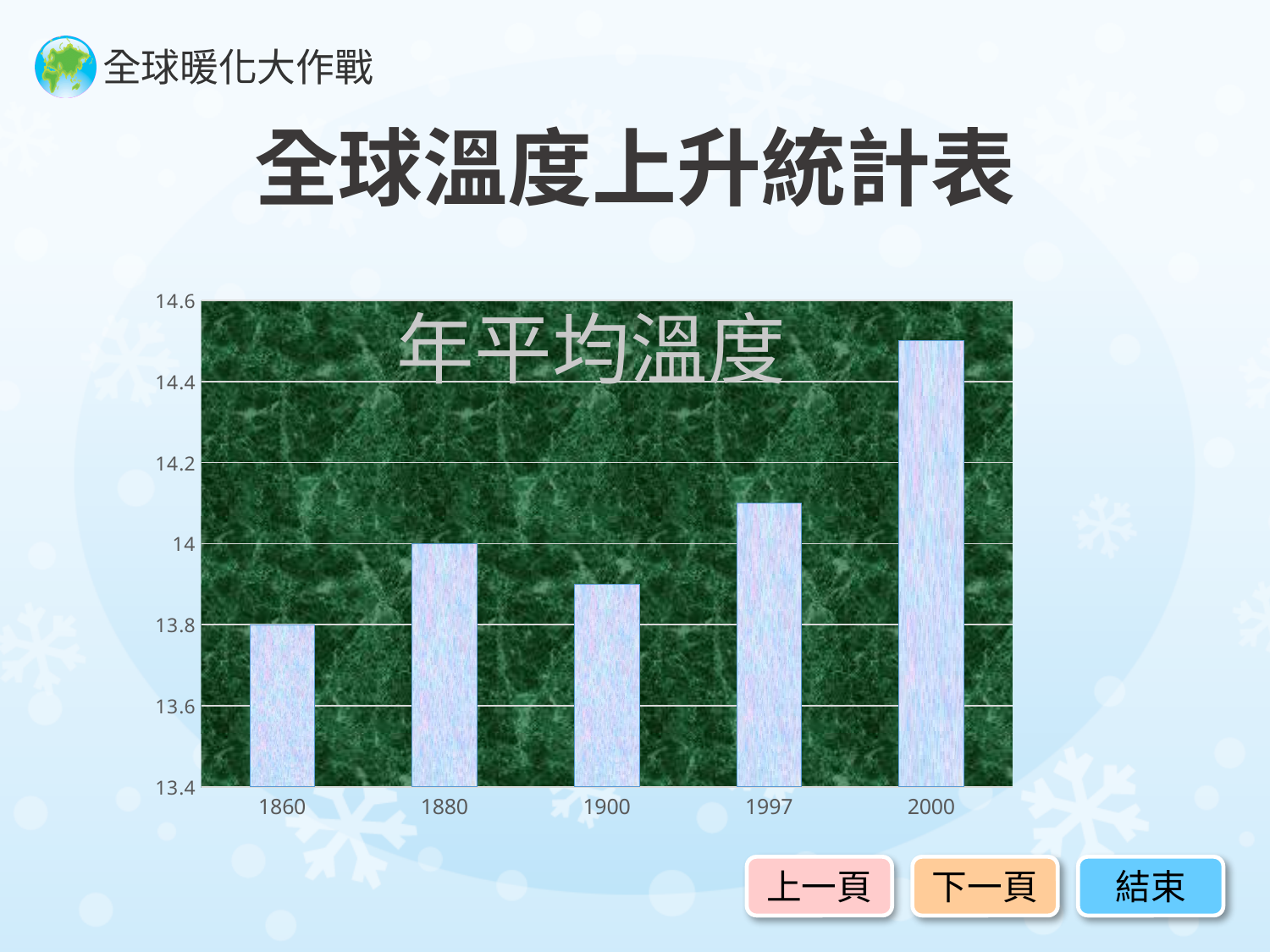
What is the difference between the values for 1880 and 1860? 0.2 Which is larger, the value for 1997 or the value for 1900? 1997 Is the value for 1900 greater or less than 14? less What type of chart is shown on the slide? bar chart What is the title of the chart? 年平均溫度 What is the value for 1860? 13.8 Which year has the lowest value? 1860 How many years (categories) are plotted on the x axis? 5 Which year has the highest value? 2000 Overall, do the values rise or fall from 1860 to 2000? rise What is the value for 1880? 14 Is the value for 2000 greater or less than 14.4? greater